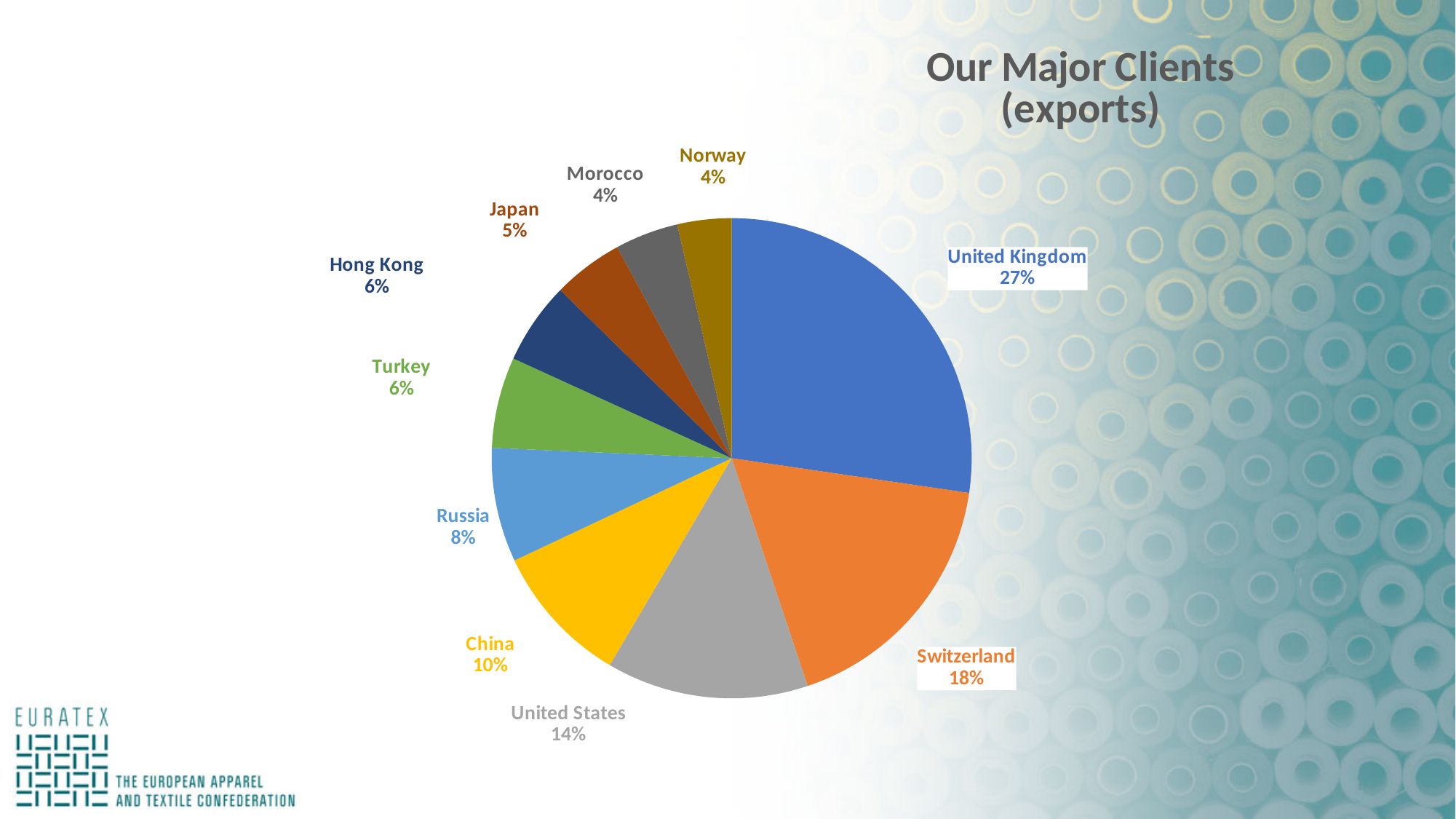
What share of exports goes to the United States? 14% What share of exports goes to the United Kingdom? 27% What is the difference in share between the United Kingdom and Switzerland? 9% How many clients (slices) are shown in the pie chart? 10 Which has a larger share of exports, China or Russia? China What share of exports goes to Switzerland? 18% What kind of chart is shown on the slide? pie chart Which client has the largest share of exports? United Kingdom What is the title of the chart? Our Major Clients (exports) What share of exports goes to Russia? 8% Which has a larger share of exports, Japan or Turkey? Turkey What is the difference in share between the United States and China? 4%